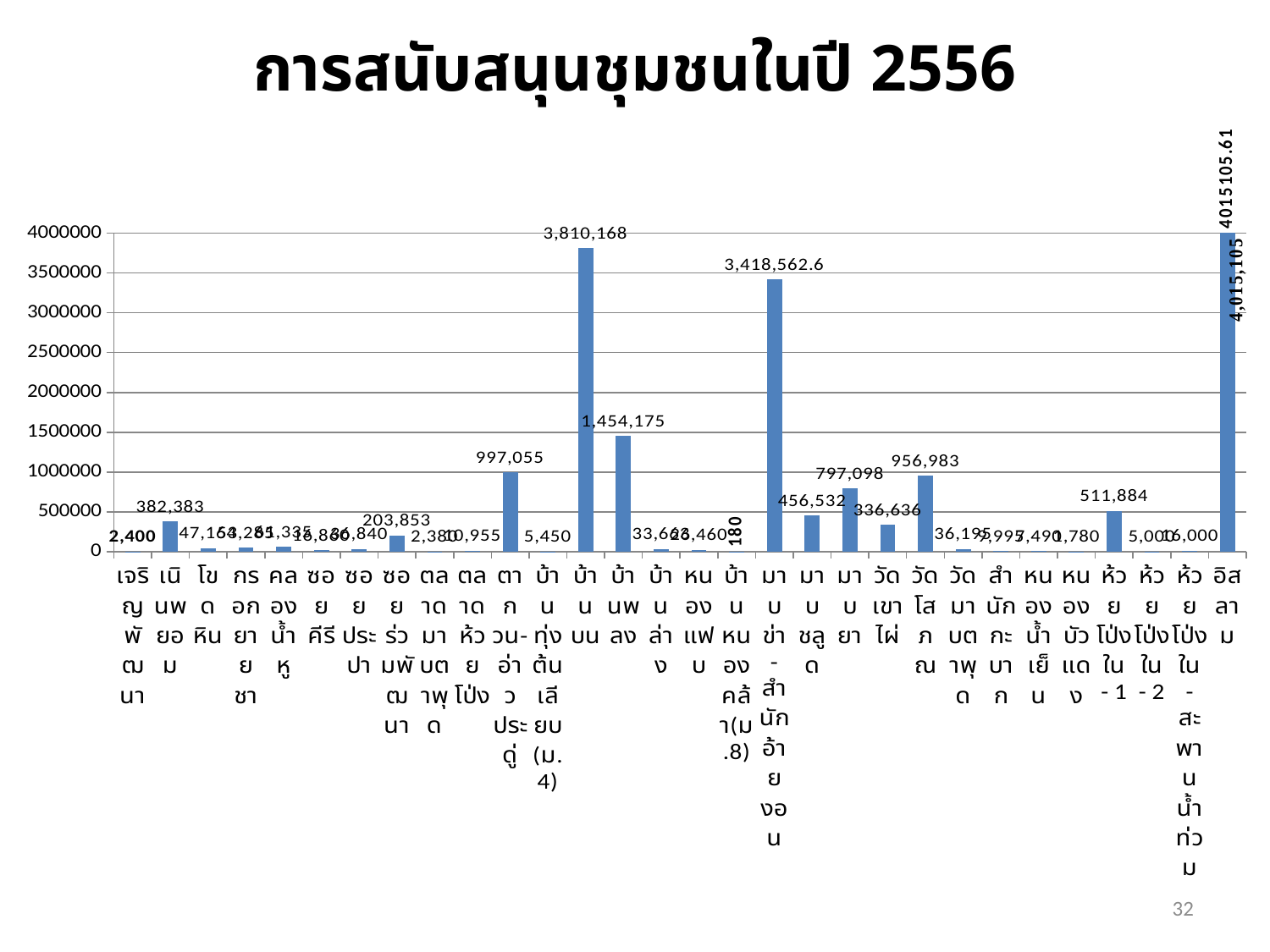
What is the value for บ้านบน? 3,810,168 Is the value for บ้านบน greater or less than 3500000? greater What is the title of the chart? การสนับสนุนชุมชนในปี 2556 What is the value for บ้านพลง? 1,454,175 What is the value for ตากวน-อ่าวประดู่? 997,055 What type of chart is shown on the slide? bar chart Which community has the highest value in the chart? อิสลาม How many communities are shown on the x axis of the chart? 30 What is the value for ห้วยโป่งใน-1? 511,884 Which has a larger value, มาบยา or มาบชลูด? มาบยา What is the difference between the values for บ้านบน and บ้านพลง? 2,355,993 What is the value for มาบข่า-สำนักอ้ายงอน? 3,418,562.6